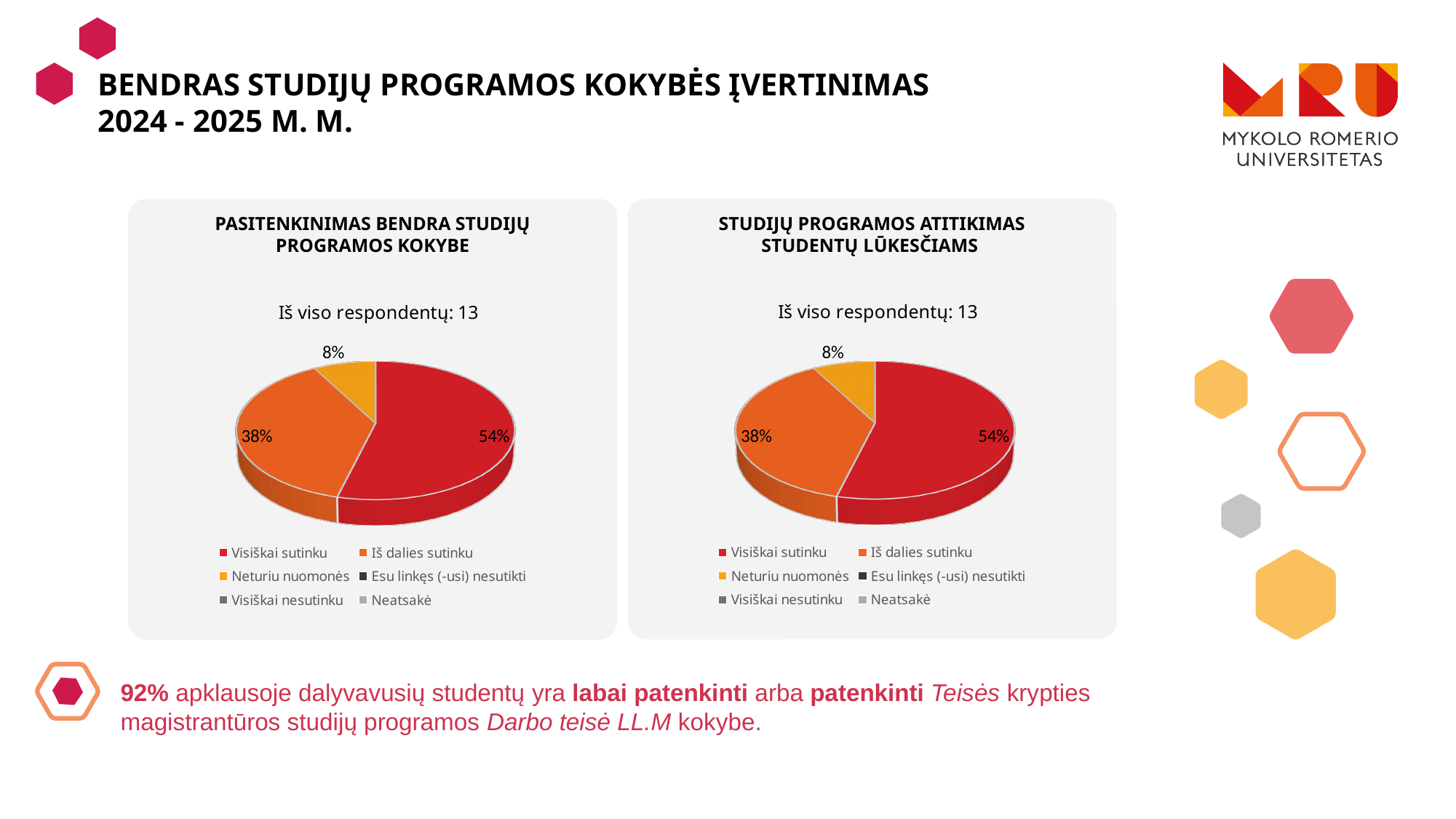
How many entries does the legend of the chart titled "Studijų programos atitikimas studentų lūkesčiams" list? 6 How many respondents in total are reported for the chart titled "Pasitenkinimas bendra studijų programos kokybe"? 13 In the chart titled "Studijų programos atitikimas studentų lūkesčiams", which response category has the largest slice? Visiškai sutinku In the chart titled "Pasitenkinimas bendra studijų programos kokybe", what is the difference in percentage points between "Visiškai sutinku" and "Iš dalies sutinku"? 16 percentage points In the chart titled "Pasitenkinimas bendra studijų programos kokybe", what share of respondents answered "Visiškai sutinku"? 54% In the chart titled "Pasitenkinimas bendra studijų programos kokybe", what share of respondents answered "Iš dalies sutinku"? 38% In the chart titled "Studijų programos atitikimas studentų lūkesčiams", what share of respondents answered "Neturiu nuomonės"? 8% In the chart titled "Pasitenkinimas bendra studijų programos kokybe", what share of respondents answered "Neturiu nuomonės"? 8% In the chart titled "Studijų programos atitikimas studentų lūkesčiams", which is larger: "Iš dalies sutinku" or "Neturiu nuomonės"? Iš dalies sutinku In the chart titled "Pasitenkinimas bendra studijų programos kokybe", which response category has the smallest visible slice? Neturiu nuomonės What type of chart is used in the chart titled "Pasitenkinimas bendra studijų programos kokybe"? Pie chart In the chart titled "Studijų programos atitikimas studentų lūkesčiams", what share of respondents answered "Visiškai sutinku"? 54%